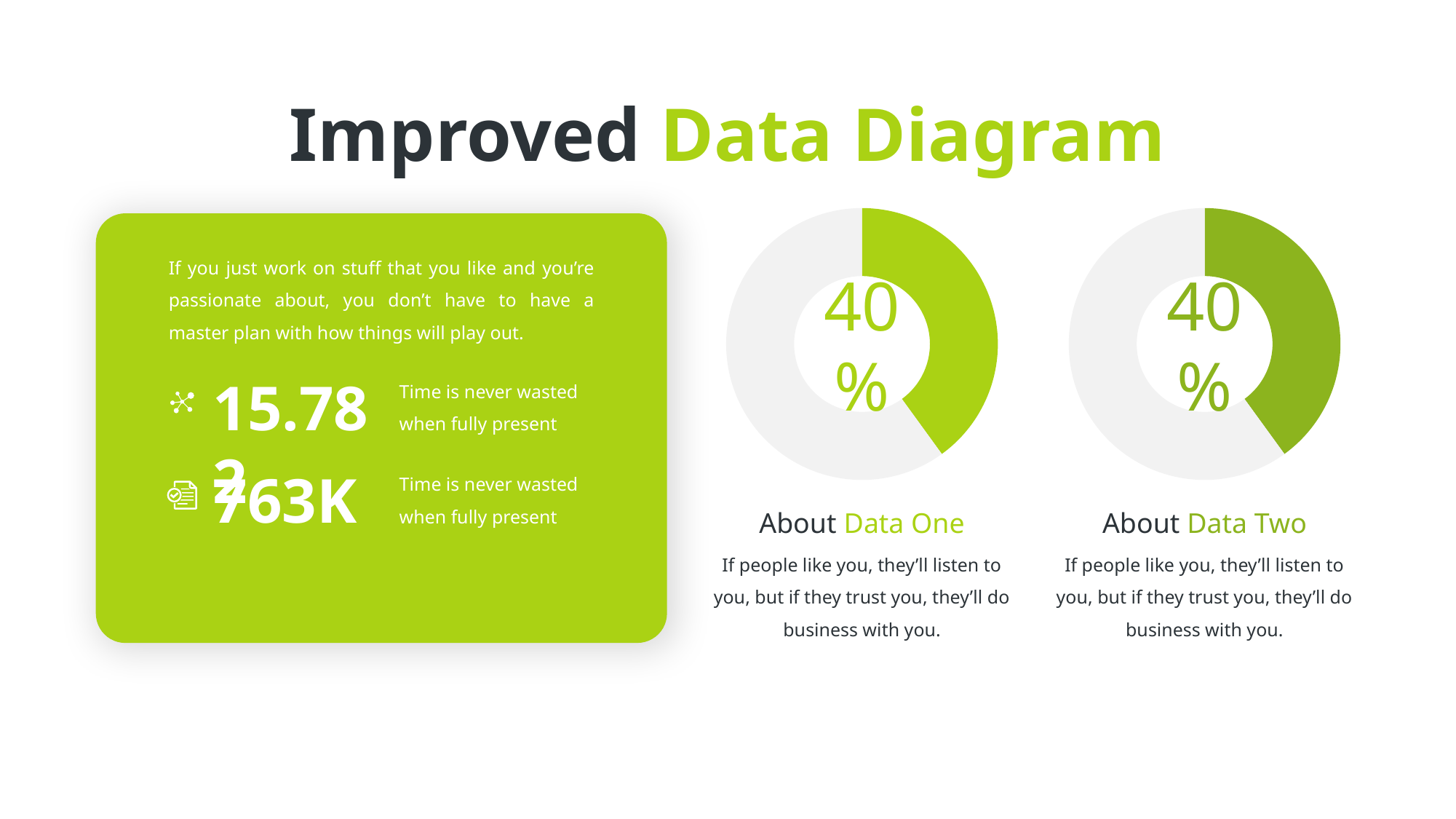
How many donut charts are on the slide? 2 In the 'About Data One' donut chart, what share of the ring is left grey (not highlighted)? 60% In the 'About Data Two' donut chart, is the highlighted green portion greater or less than 50%? less What percentage is shown in the centre of the 'About Data Two' donut chart? 40% What is the title of the slide containing the donut charts? Improved Data Diagram Do the 'About Data One' and 'About Data Two' donut charts show the same percentage? Yes What kind of chart is used for 'About Data One'? Donut (pie) chart What percentage is shown in the centre of the 'About Data One' donut chart? 40% Which donut chart uses the darker green colour for its highlighted segment, 'About Data One' or 'About Data Two'? About Data Two In the 'About Data One' donut chart, is the highlighted green portion greater or less than 50%? less